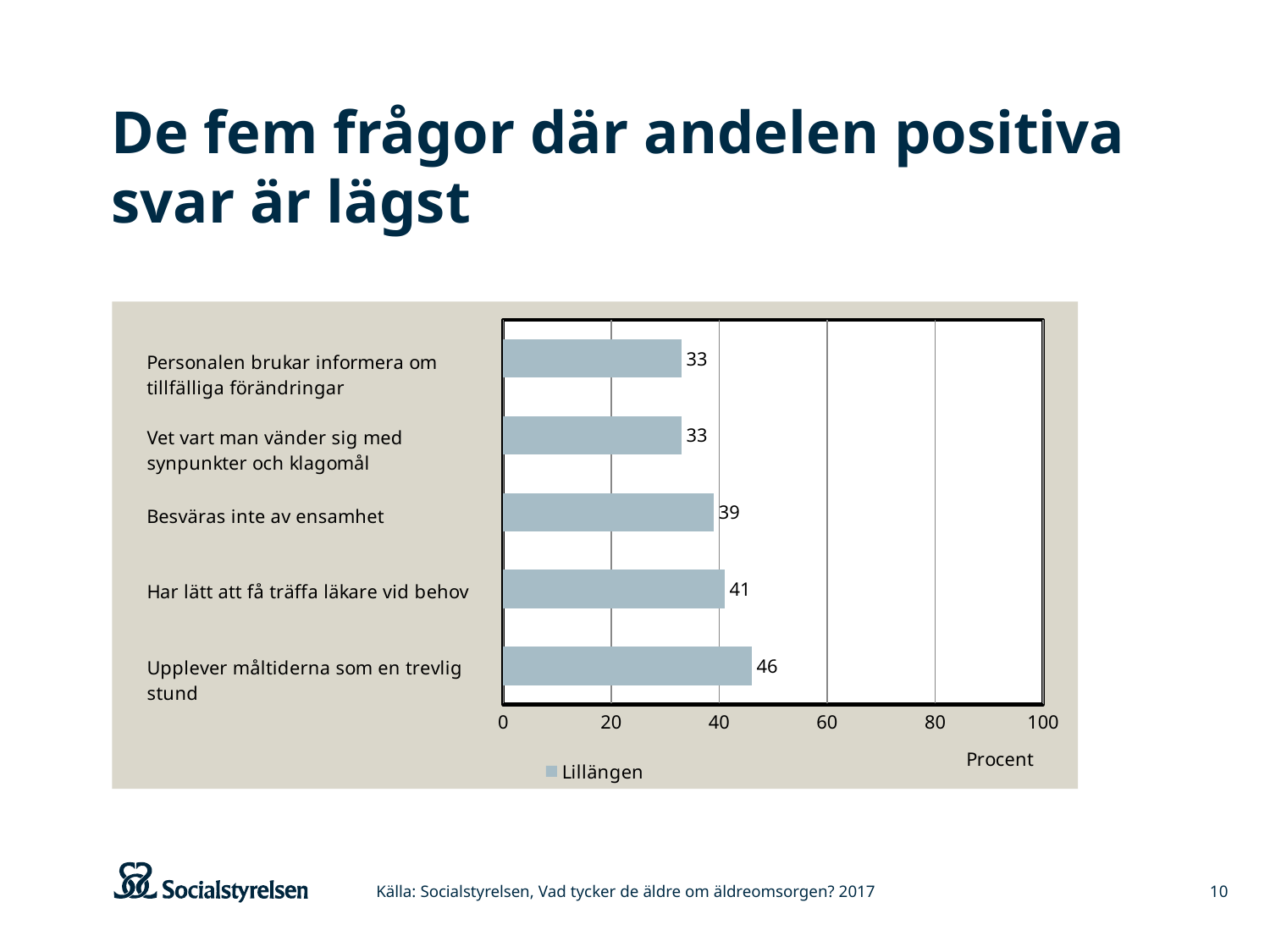
What is the difference between the values for "Har lätt att få träffa läkare vid behov" and "Personalen brukar informera om tillfälliga förändringar"? 8 What kind of chart is shown on the slide? Bar chart Is the value for "Upplever måltiderna som en trevlig stund" greater or less than 40? greater Which category has the highest value? Upplever måltiderna som en trevlig stund How many series does the legend list? 1 What is the value for "Vet vart man vänder sig med synpunkter och klagomål"? 33 What is the value for "Har lätt att få träffa läkare vid behov"? 41 What is the value for "Besväras inte av ensamhet"? 39 What is the value for "Upplever måltiderna som en trevlig stund"? 46 How many categories are shown in the chart? 5 What is the difference between the values for "Upplever måltiderna som en trevlig stund" and "Besväras inte av ensamhet"? 7 Which is larger, the value for "Besväras inte av ensamhet" or the value for "Har lätt att få träffa läkare vid behov"? Har lätt att få träffa läkare vid behov